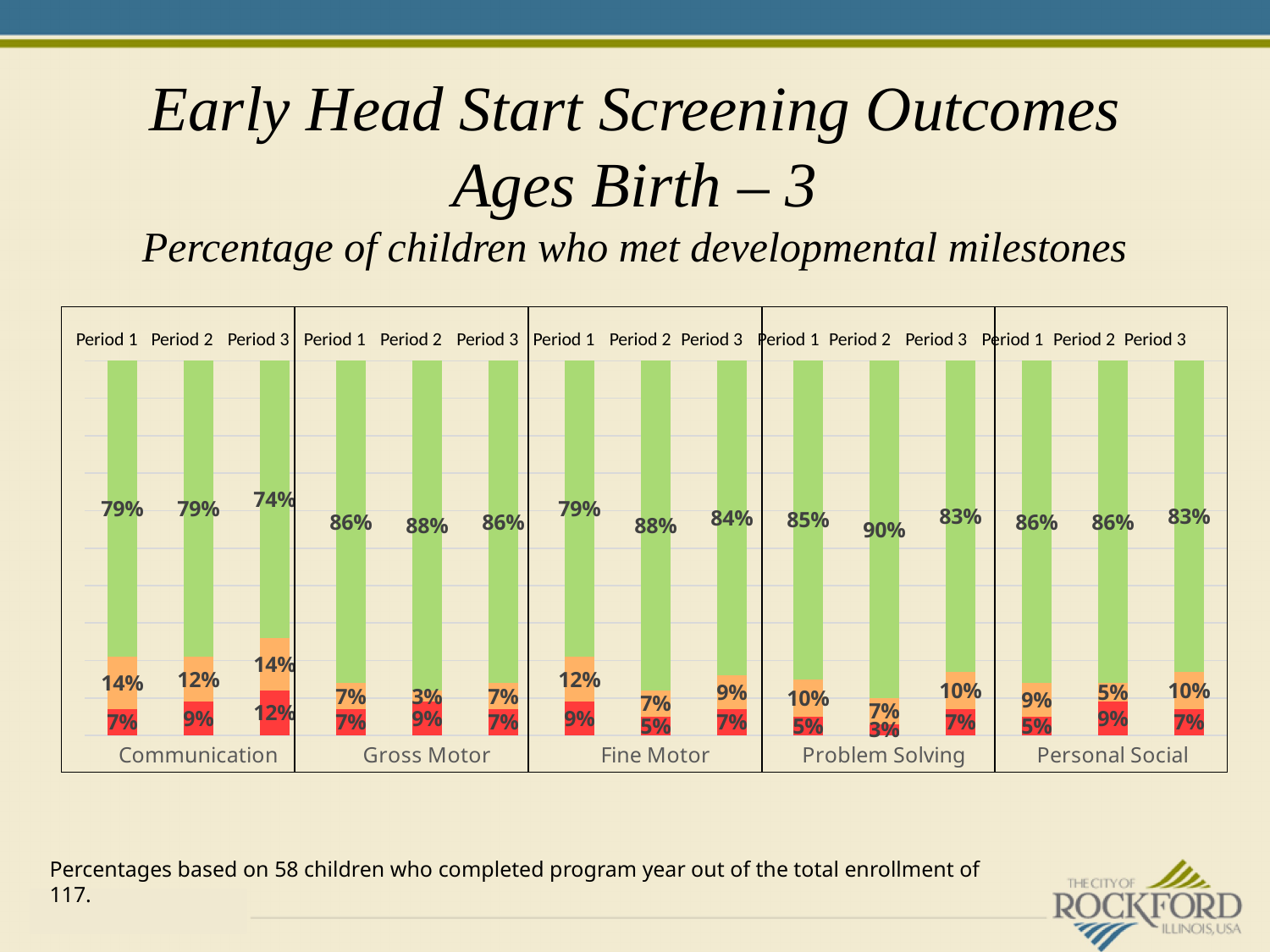
How many developmental domain groups are shown on the x axis? 5 What is the green segment value for Period 3 in the Communication group? 74% Do the green segment values in the Communication group rise or fall from Period 1 to Period 3? Fall How many bars are plotted in total across all groups? 15 Which group and period has the highest green segment value? Problem Solving, Period 2 Which is larger: the green segment for Period 1 in Communication or the green segment for Period 1 in Gross Motor? Gross Motor Period 1 What kind of chart is shown on the slide? Stacked bar chart Which group and period has the lowest green segment value? Communication, Period 3 What is the red segment value for Period 2 in the Problem Solving group? 3% What is the difference between the green segment values for Period 2 and Period 3 in the Problem Solving group? 7% What is the orange segment value for Period 1 in the Fine Motor group? 12% What is the green segment value for Period 2 in the Problem Solving group? 90%